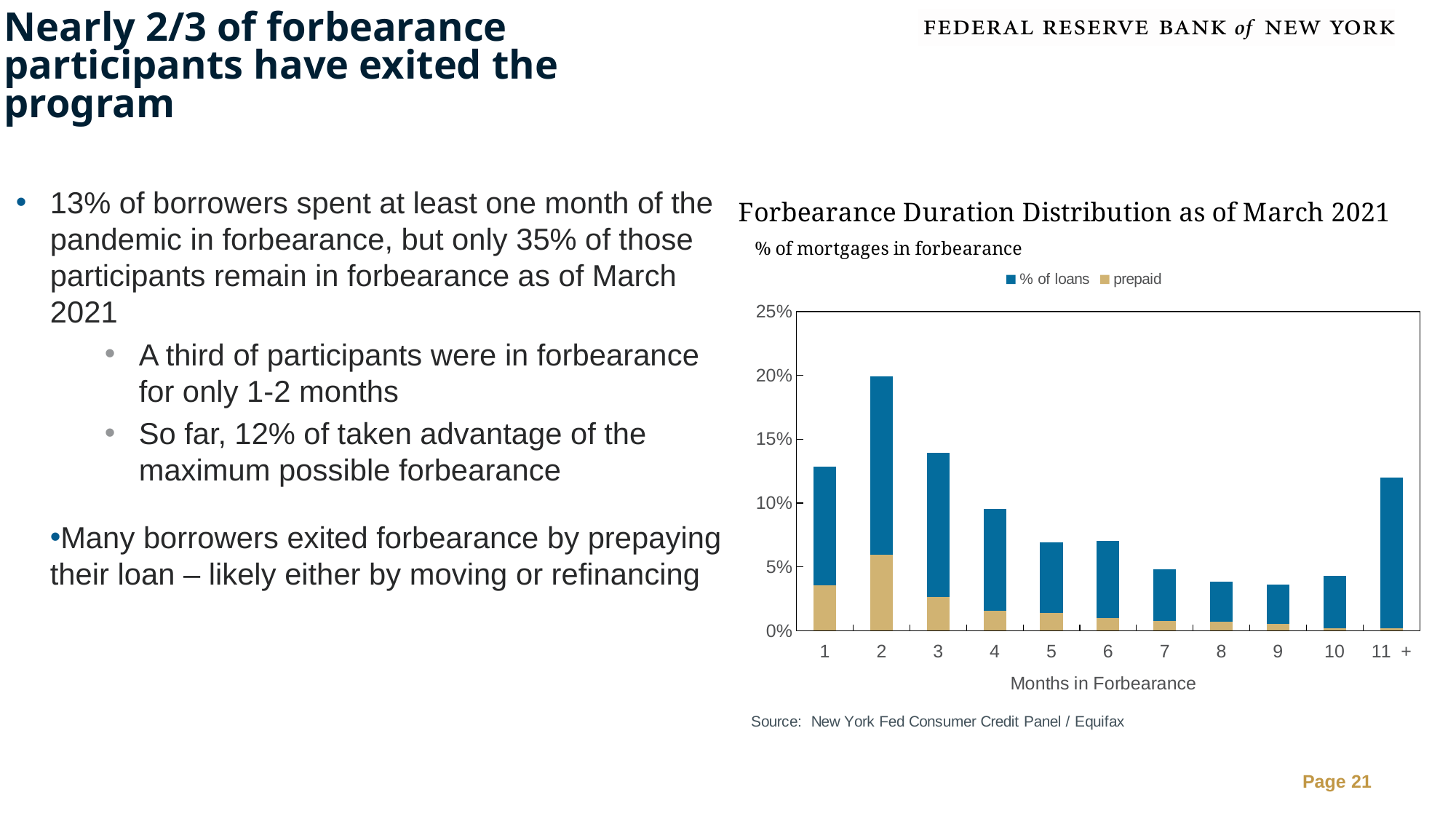
What kind of chart is shown on the slide? Bar chart Is the total bar for 4 months in forbearance greater or less than 10%? less How many categories are shown on the x axis of the chart? 11 Do the total bar heights rise or fall from 2 months to 9 months in forbearance? fall Is the total bar for 10 months in forbearance greater or less than 5%? less Is the total bar for 2 months in forbearance greater or less than 15%? greater How many series does the chart legend list? 2 What are the two series named in the legend? % of loans and prepaid Which months-in-forbearance category has the tallest bar? 2 Which has the larger total bar: 2 months or 11+ months in forbearance? 2 months What is the title of the chart? Forbearance Duration Distribution as of March 2021